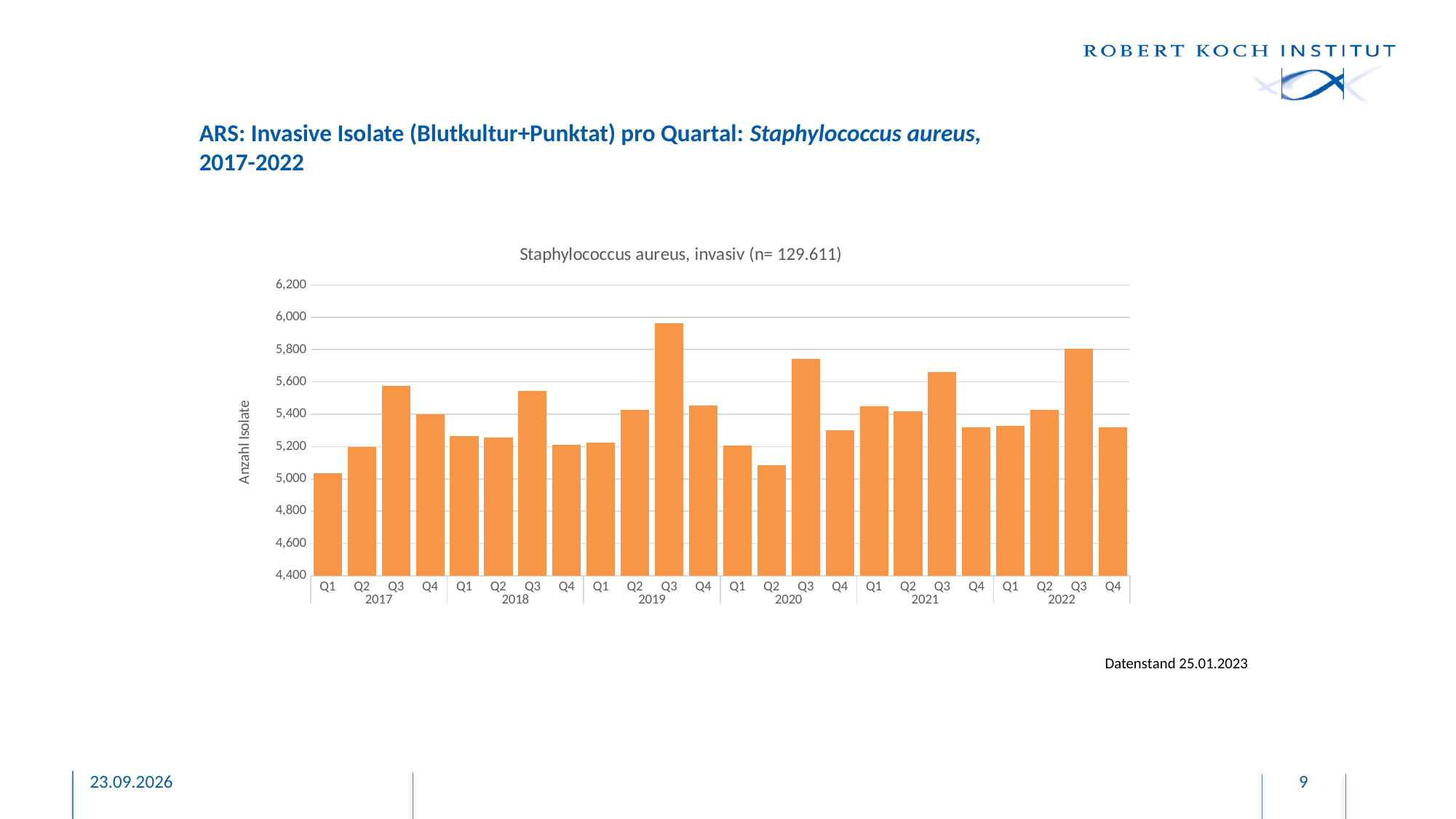
Which quarter has the highest number of isolates? Q3 2019 Is the value for Q3 2019 greater or less than 5,800? greater Which is larger, the value for Q3 2019 or the value for Q3 2022? Q3 2019 Is the value for Q2 2020 greater or less than 5,200? less What kind of chart is shown on the slide? bar chart Is the value for Q1 2017 greater or less than 5,200? less How many quarterly bars are plotted in the chart? 24 Which is larger, the value for Q1 2017 or the value for Q1 2018? Q1 2018 What is the label on the vertical axis of the chart? Anzahl Isolate Do the values rise or fall from Q1 2019 to Q3 2019? rise